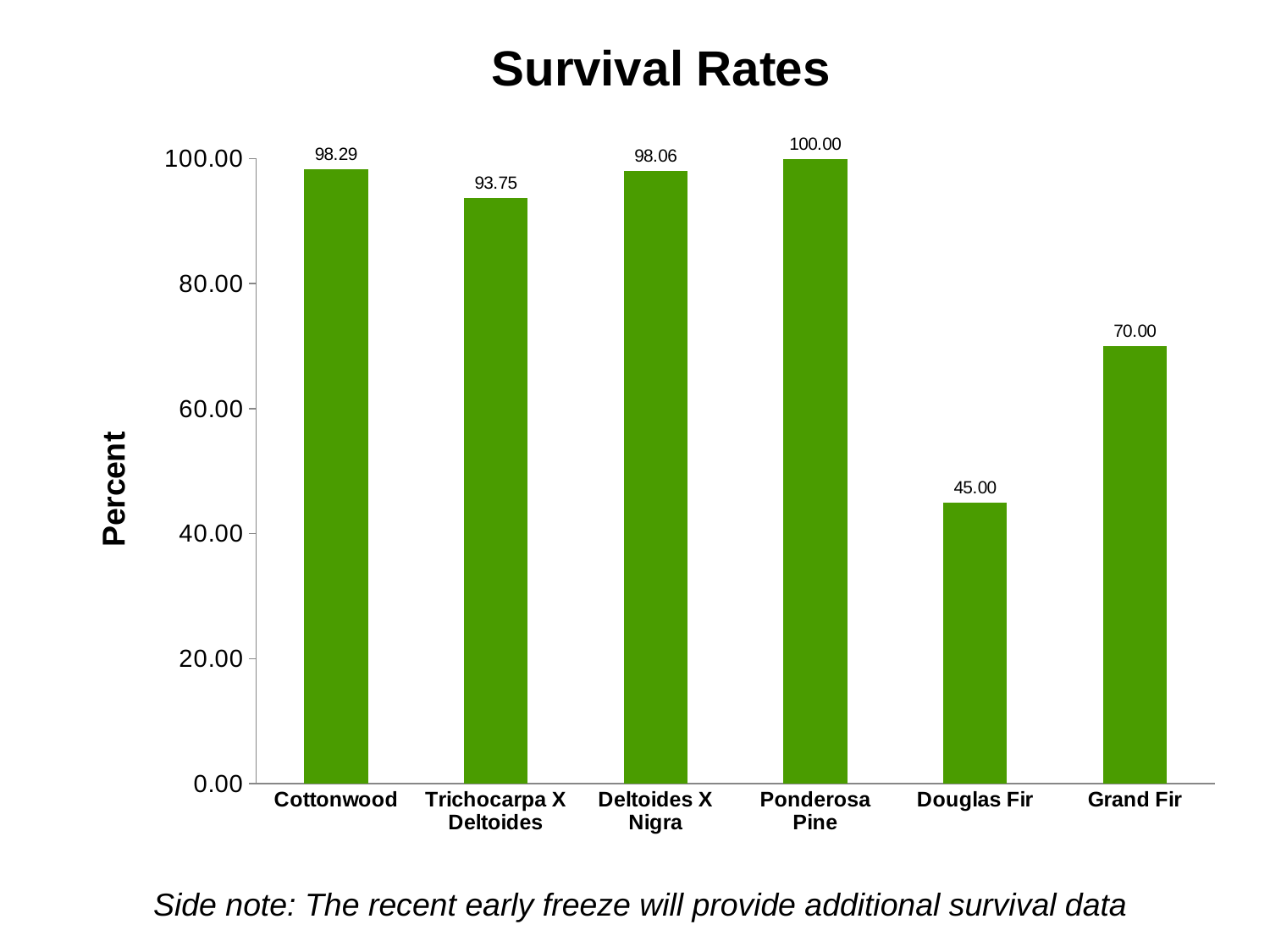
Which category has the lowest survival rate? Douglas Fir What is the difference between the survival rates of Ponderosa Pine and Trichocarpa X Deltoides? 6.25 What is the title of the chart? Survival Rates What is the survival rate for Trichocarpa X Deltoides? 93.75 Is the value for Douglas Fir greater or less than 60.00? less Which has a higher survival rate, Cottonwood or Grand Fir? Cottonwood How many categories are shown in the chart? 6 Which category has the highest survival rate? Ponderosa Pine What is the difference between the survival rates of Grand Fir and Douglas Fir? 25.00 What kind of chart is shown on the slide? Bar chart What is the survival rate for Douglas Fir? 45.00 What is the survival rate for Cottonwood? 98.29